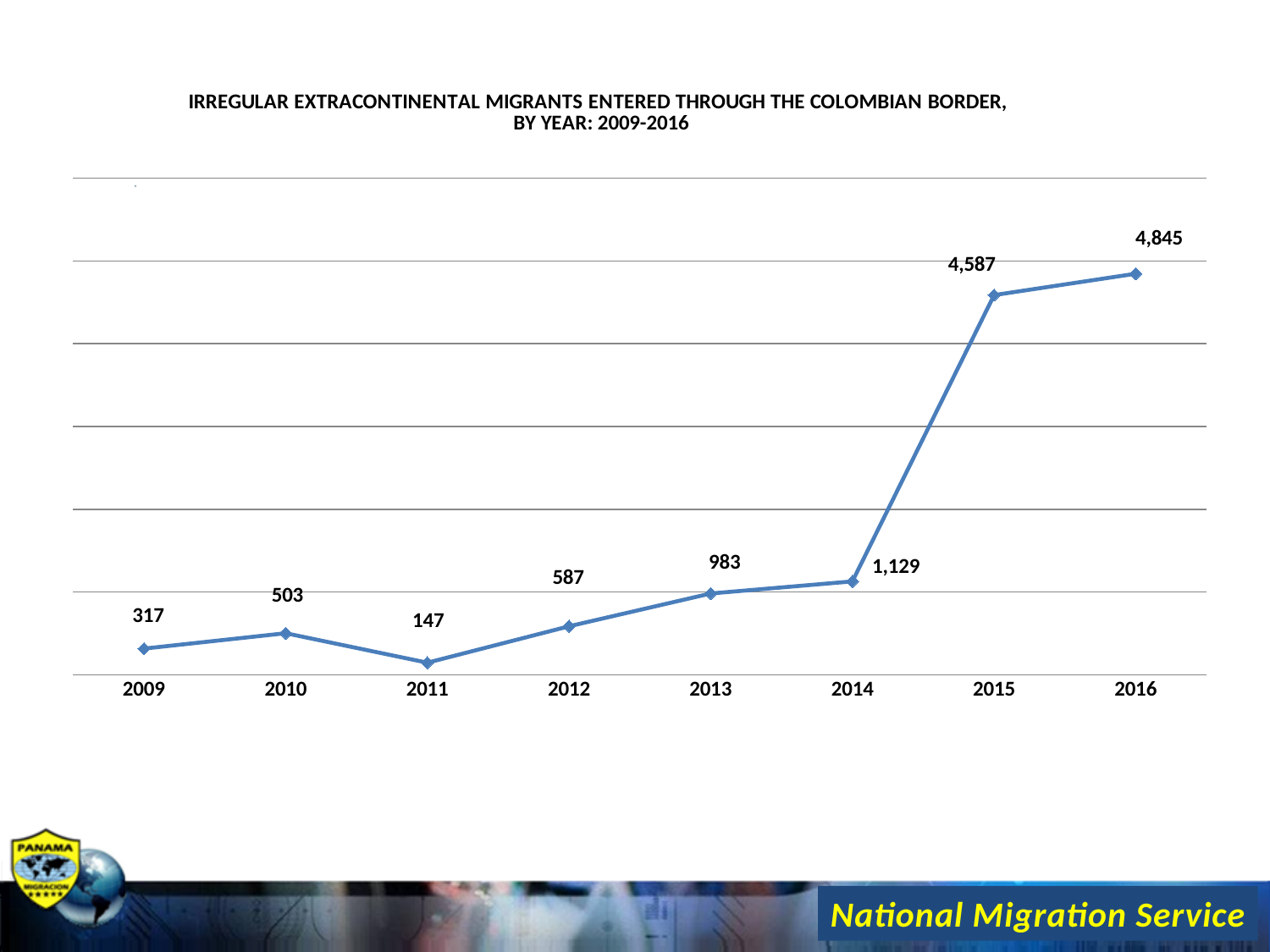
Which year has the lowest value? 2011 What is the title of the chart? IRREGULAR EXTRACONTINENTAL MIGRANTS ENTERED THROUGH THE COLOMBIAN BORDER, BY YEAR: 2009-2016 Between 2014 and 2016, do the values rise or fall? rise Which is larger, the value for 2010 or the value for 2013? 2013 What type of chart is shown on the slide? line chart What is the value for 2014? 1,129 What is the value for 2012? 587 How many years are plotted on the chart? 8 What is the difference between the values for 2016 and 2015? 258 How many irregular extracontinental migrants entered through the Colombian border in 2009? 317 Which year has the highest value? 2016 What is the difference between the values for 2015 and 2014? 3,458